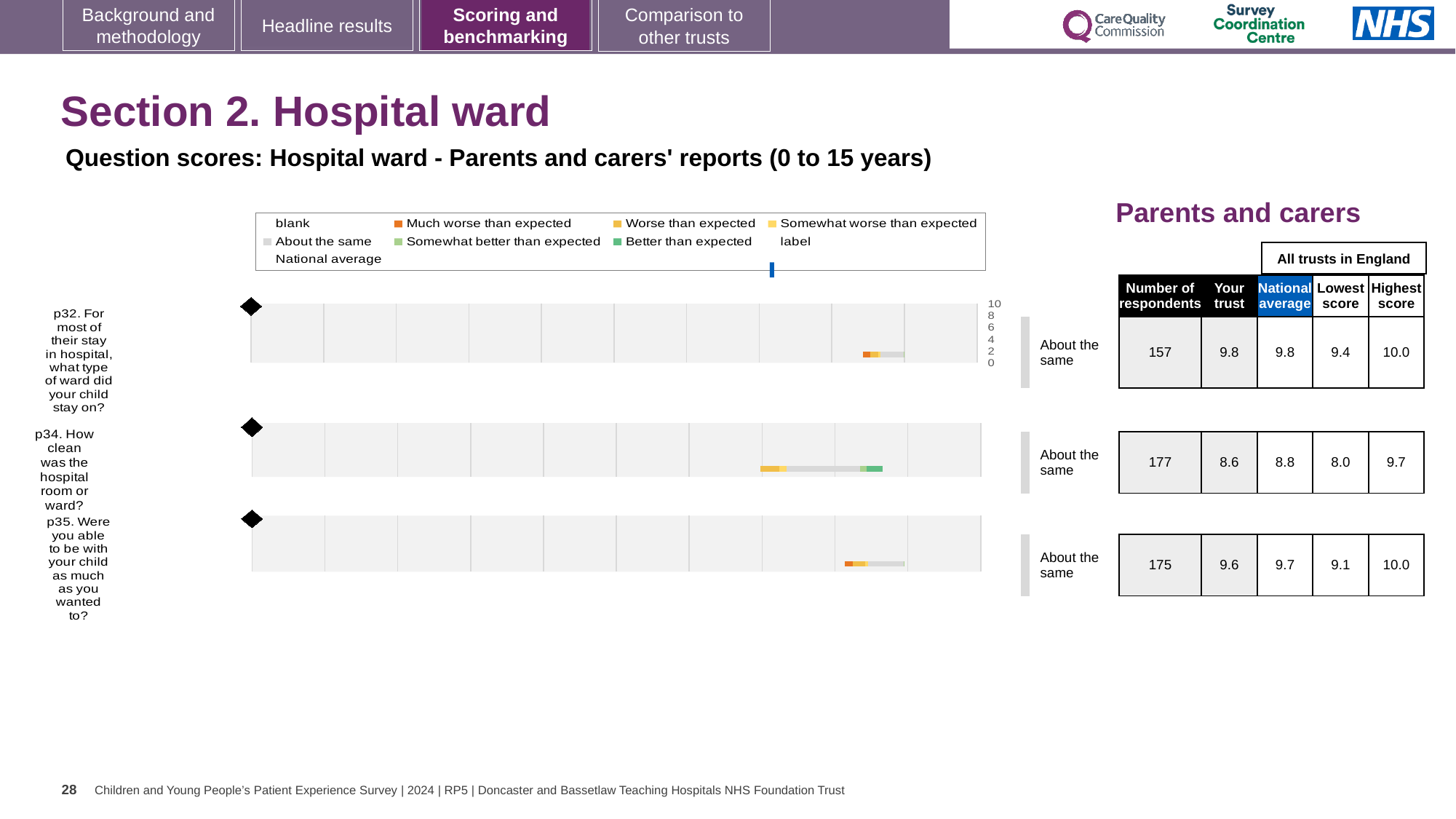
What colour does the legend use for 'Much worse than expected'? Orange Which question has the highest 'Your trust' score? p32 For p34, what is the difference between the highest score and the lowest score across all trusts in England? 1.7 For p35, which is larger: the 'Your trust' score or the national average? National average How many questions (categories) are plotted in the chart? 3 What is the national average score for p35 (Were you able to be with your child as much as you wanted to)? 9.7 How many respondents answered p32 (what type of ward did your child stay on)? 157 How many entries does the chart legend list? 9 What is the 'Your trust' score for p34 (How clean was the hospital room or ward?)? 8.6 Which question has the lowest national average score? p34 What kind of chart is shown on the slide? bar chart What benchmark category is shown for all three questions on the slide? About the same